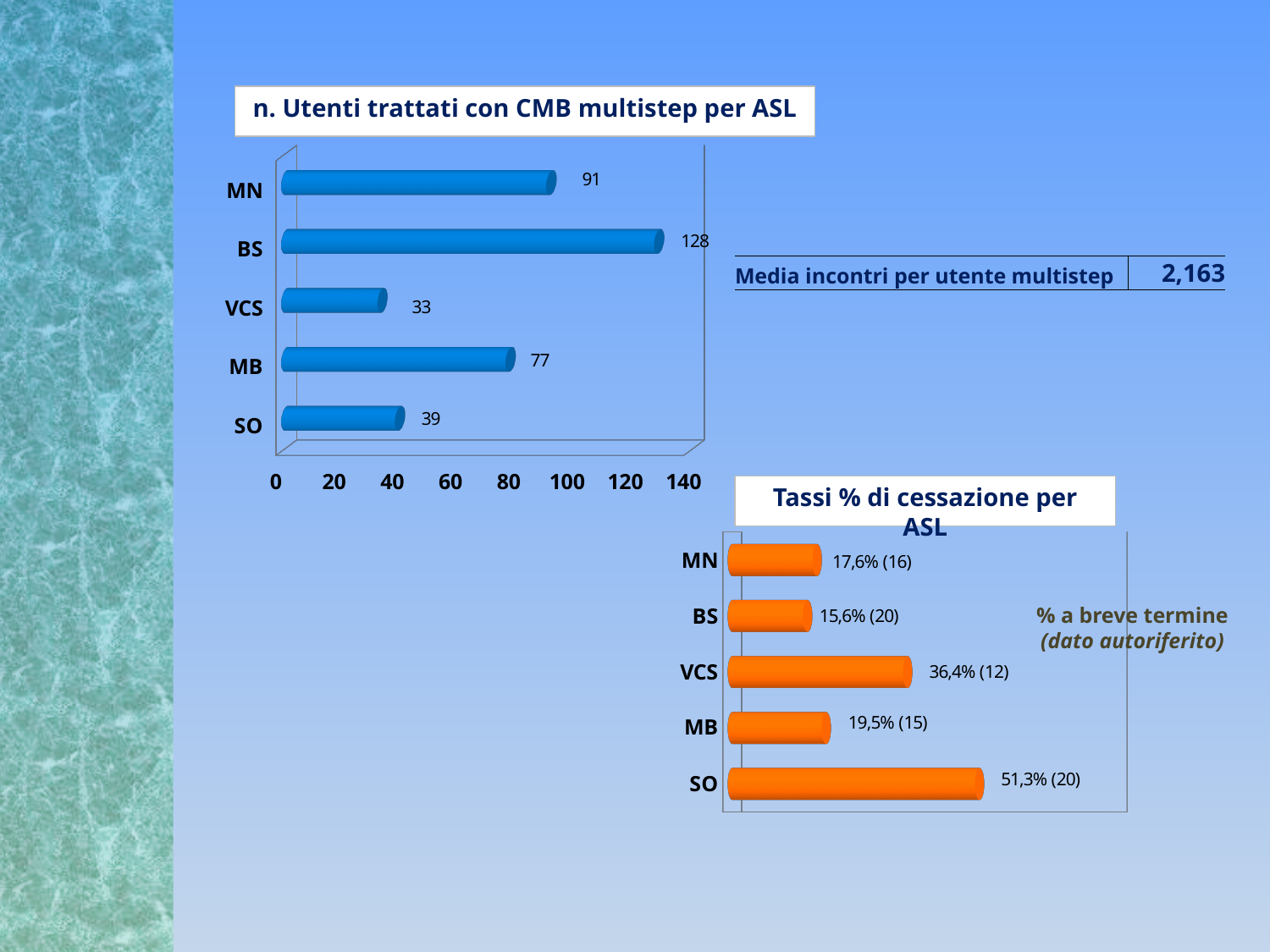
In the chart 'Tassi % di cessazione per ASL', which ASL has the lowest cessation rate? BS In the chart 'n. Utenti trattati con CMB multistep per ASL', which is larger, the value for MB or the value for SO? MB What kind of chart is 'n. Utenti trattati con CMB multistep per ASL'? Bar chart In the chart 'Tassi % di cessazione per ASL', what colour are the bars? Orange In the chart 'n. Utenti trattati con CMB multistep per ASL', how many ASL categories are shown? 5 In the chart 'n. Utenti trattati con CMB multistep per ASL', which ASL has the lowest value? VCS In the chart 'n. Utenti trattati con CMB multistep per ASL', what is the value for BS? 128 In the chart 'n. Utenti trattati con CMB multistep per ASL', which ASL has the highest value? BS In the chart 'Tassi % di cessazione per ASL', what is the data label for SO? 51,3% (20) In the chart 'n. Utenti trattati con CMB multistep per ASL', what is the difference between the values for BS and MN? 37 In the chart 'n. Utenti trattati con CMB multistep per ASL', what is the value for VCS? 33 In the chart 'Tassi % di cessazione per ASL', what is the data label for VCS? 36,4% (12)